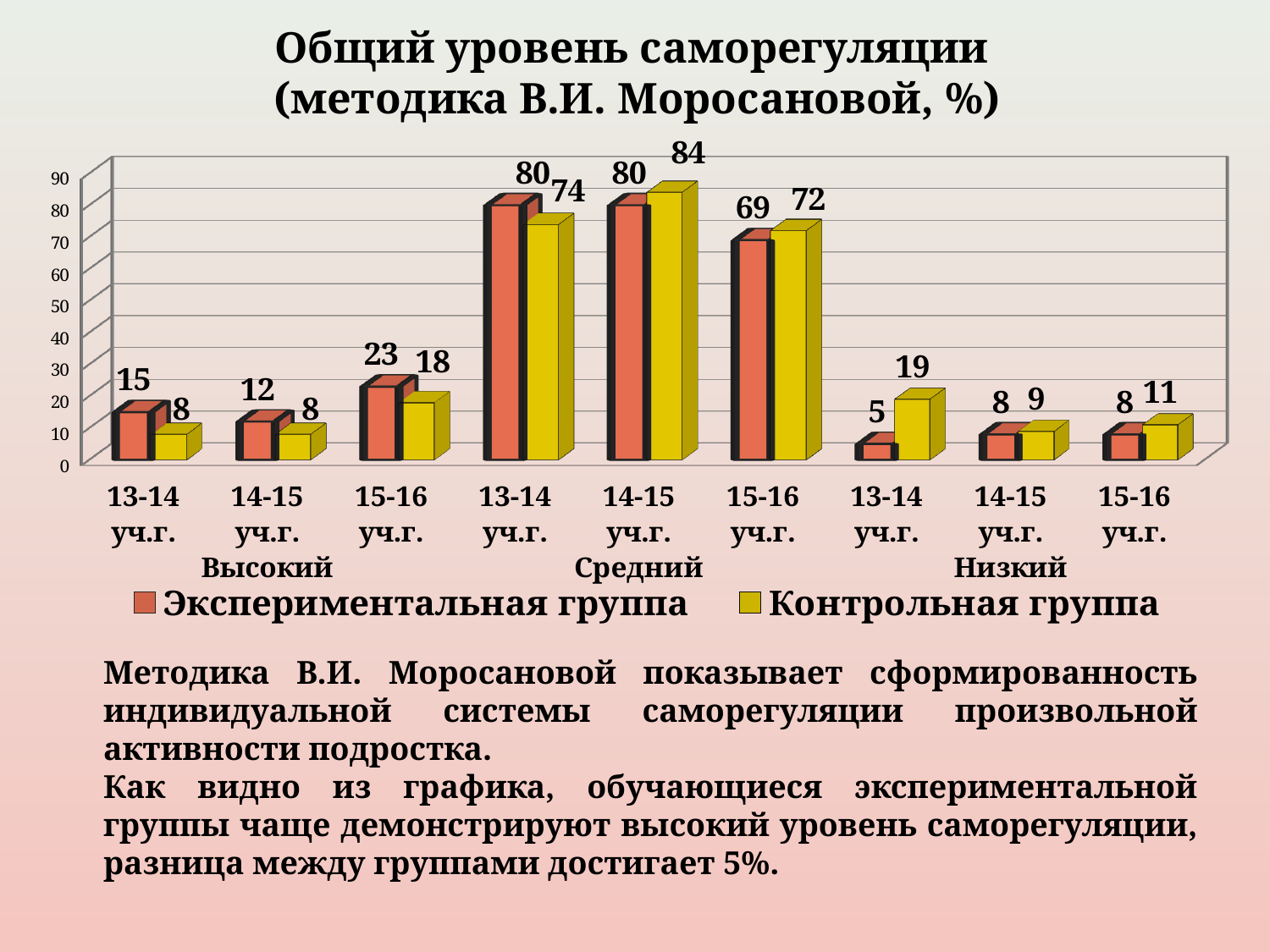
What is the value for the Контрольная группа in the Низкий level for 13-14 уч.г.? 19 Which category has the lowest value for the Экспериментальная группа? 13-14 уч.г. (Низкий) How many series does the legend list? 2 What is the value for the Контрольная группа in the Средний level for 14-15 уч.г.? 84 In the Средний level for 15-16 уч.г., which group has the larger value? Контрольная группа What is the title of the chart? Общий уровень саморегуляции (методика В.И. Моросановой, %) Which category has the highest value for the Контрольная группа? 14-15 уч.г. (Средний) Is the value for the Экспериментальная группа in the Средний level for 13-14 уч.г. greater or less than 70? greater What is the value for the Экспериментальная группа in the Высокий level for 15-16 уч.г.? 23 What type of chart is shown on the slide? Bar chart What is the difference between the Экспериментальная группа and the Контрольная группа in the Высокий level for 13-14 уч.г.? 7 How many categories are shown on the x axis? 9